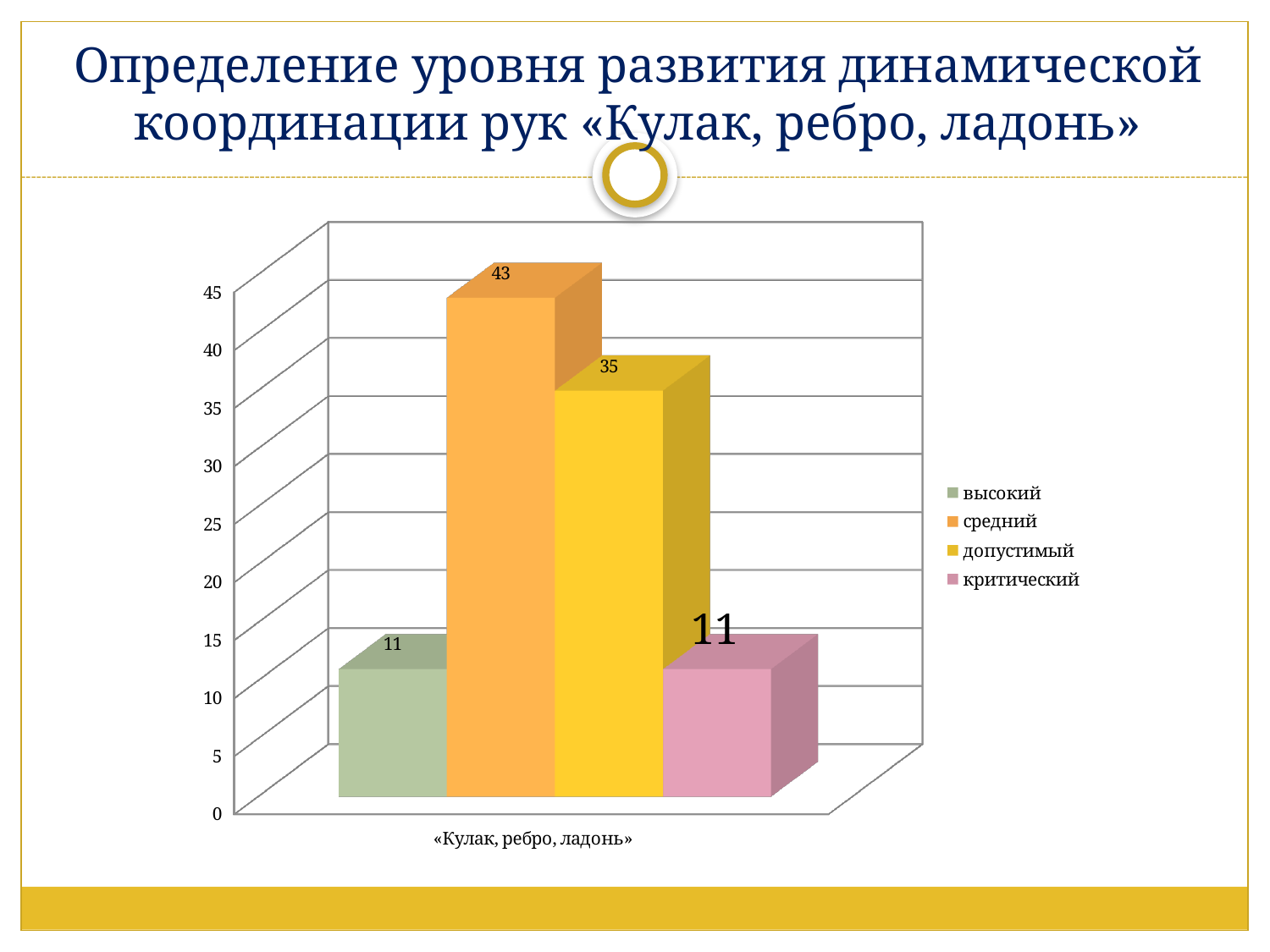
Is the value for «допустимый» greater or less than 30? greater What is the value for the series «критический»? 11 What is the value for the series «допустимый»? 35 Which series has the highest value? средний What kind of chart is shown on the slide? bar chart How many series does the legend list? 4 What is the value for the series «средний»? 43 What is the difference between the values for «средний» and «допустимый»? 8 What is the difference between the values for «допустимый» and «высокий»? 24 Which is larger, the value for «средний» or the value for «допустимый»? средний What is the category label shown on the x axis? «Кулак, ребро, ладонь» What is the value for the series «высокий»? 11